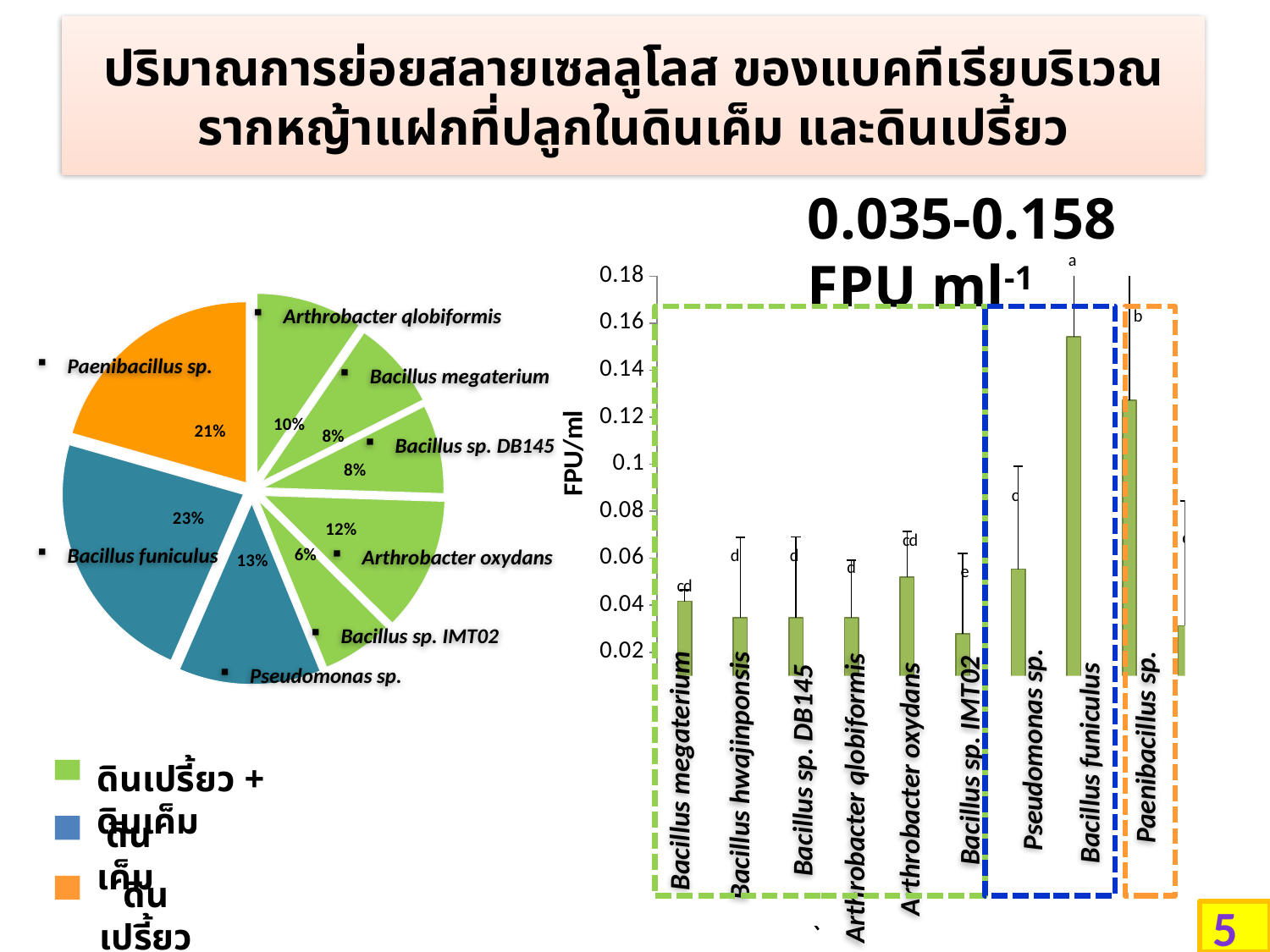
In the pie chart, how many percentage points larger is the Bacillus funiculus slice than the Paenibacillus sp. slice? 2 In the pie chart, what share does Paenibacillus sp. have? 21% In the pie chart, which slice is the smallest? Bacillus sp. IMT02 In the bar chart on the right, which bacterium has the highest FPU/ml value? Bacillus funiculus In the pie chart, which slice is the largest? Bacillus funiculus In the bar chart on the right, is the value for Paenibacillus sp. greater or less than 0.1? greater How many slices does the pie chart have? 8 In the bar chart on the right, is the value for Bacillus funiculus greater or less than 0.14? greater In the pie chart, what share does Bacillus funiculus have? 23% In the pie chart, what share does Arthrobacter oxydans have? 12% What kind of chart is the chart on the right of the slide? bar chart In the bar chart on the right, which has the larger value, Pseudomonas sp. or Bacillus megaterium? Pseudomonas sp.